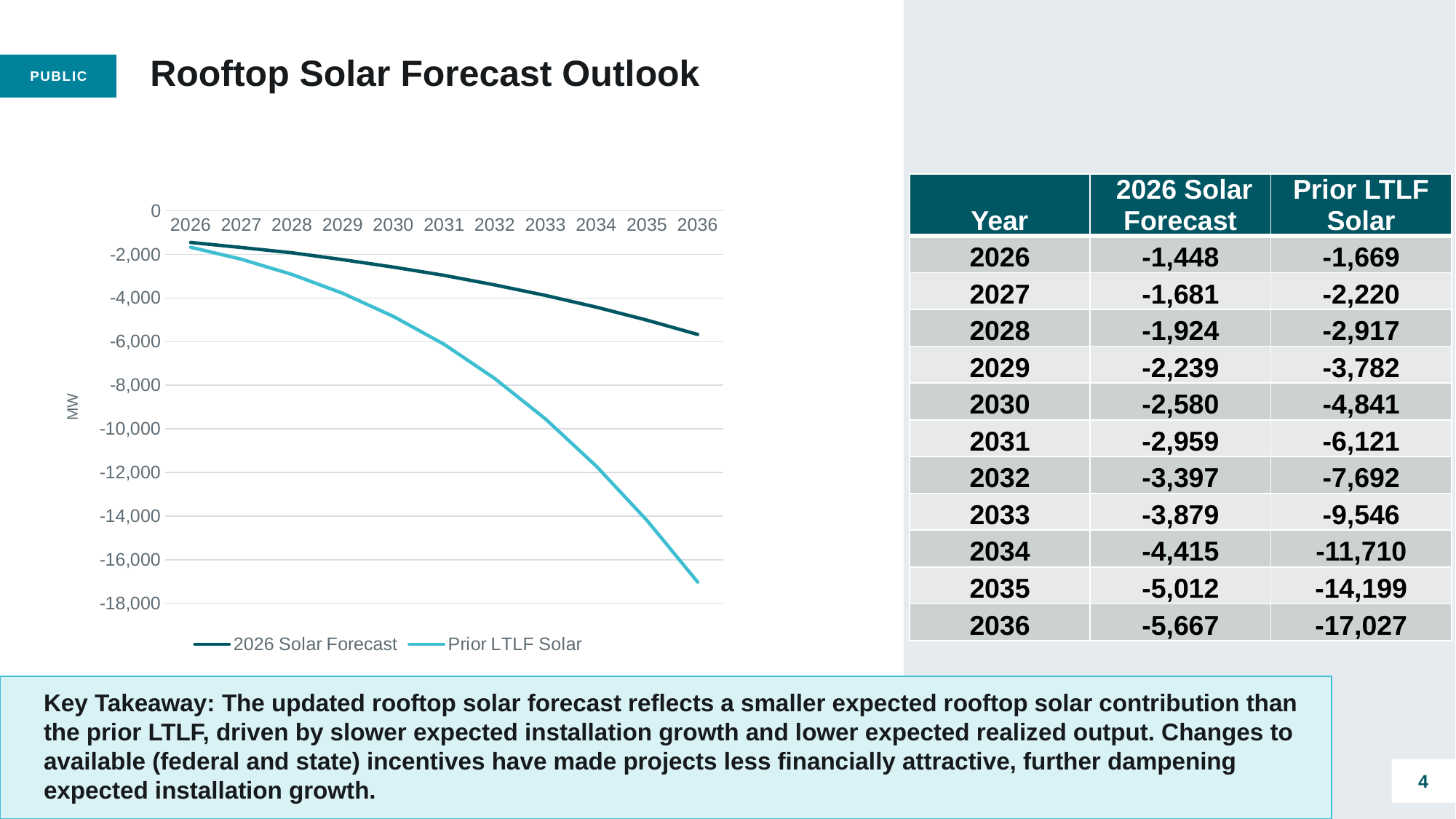
Do the values of the Prior LTLF Solar series rise or fall from 2026 to 2036? Fall What is the value of the Prior LTLF Solar series in 2036? -17,027 What kind of chart is shown on the slide? Line chart What is the value of the 2026 Solar Forecast series in 2030? -2,580 How many years are plotted along the x axis of the chart? 11 In 2036, which series has the lower value, 2026 Solar Forecast or Prior LTLF Solar? Prior LTLF Solar What unit is shown on the chart's y axis? MW In which year does the Prior LTLF Solar series reach its lowest value? 2036 What are the two legend entries of the chart? 2026 Solar Forecast and Prior LTLF Solar Is the Prior LTLF Solar value for 2033 greater or less than -8,000? less How many series does the chart's legend list? 2 What is the difference between the 2026 Solar Forecast and Prior LTLF Solar values in 2036? 11,360